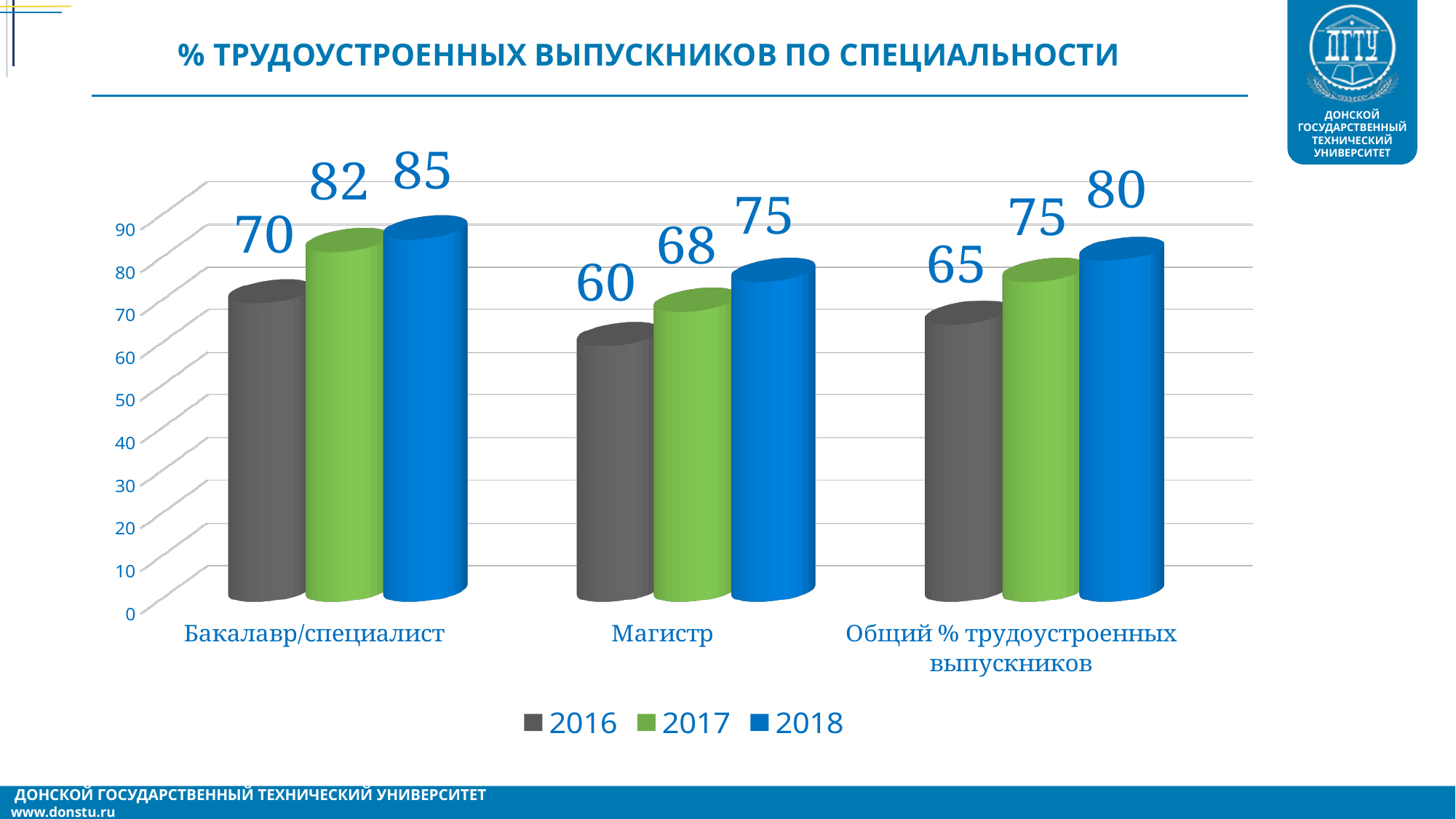
How many categories are shown on the x axis? 3 Which is larger: the 2017 value for Бакалавр/специалист or the 2017 value for Магистр? Бакалавр/специалист What kind of chart is shown on the slide? Bar chart What is the difference between the 2018 and 2016 values for Магистр? 15 What is the value for Магистр in 2016? 60 What is the value for Общий % трудоустроенных выпускников in 2017? 75 How many series does the legend list? 3 What is the value for Бакалавр/специалист in 2018? 85 Is the 2016 value for Общий % трудоустроенных выпускников greater or less than 70? less Which category has the highest value in 2018? Бакалавр/специалист Which category has the lowest value in 2016? Магистр Do the values for Магистр rise or fall from 2016 to 2018? Rise